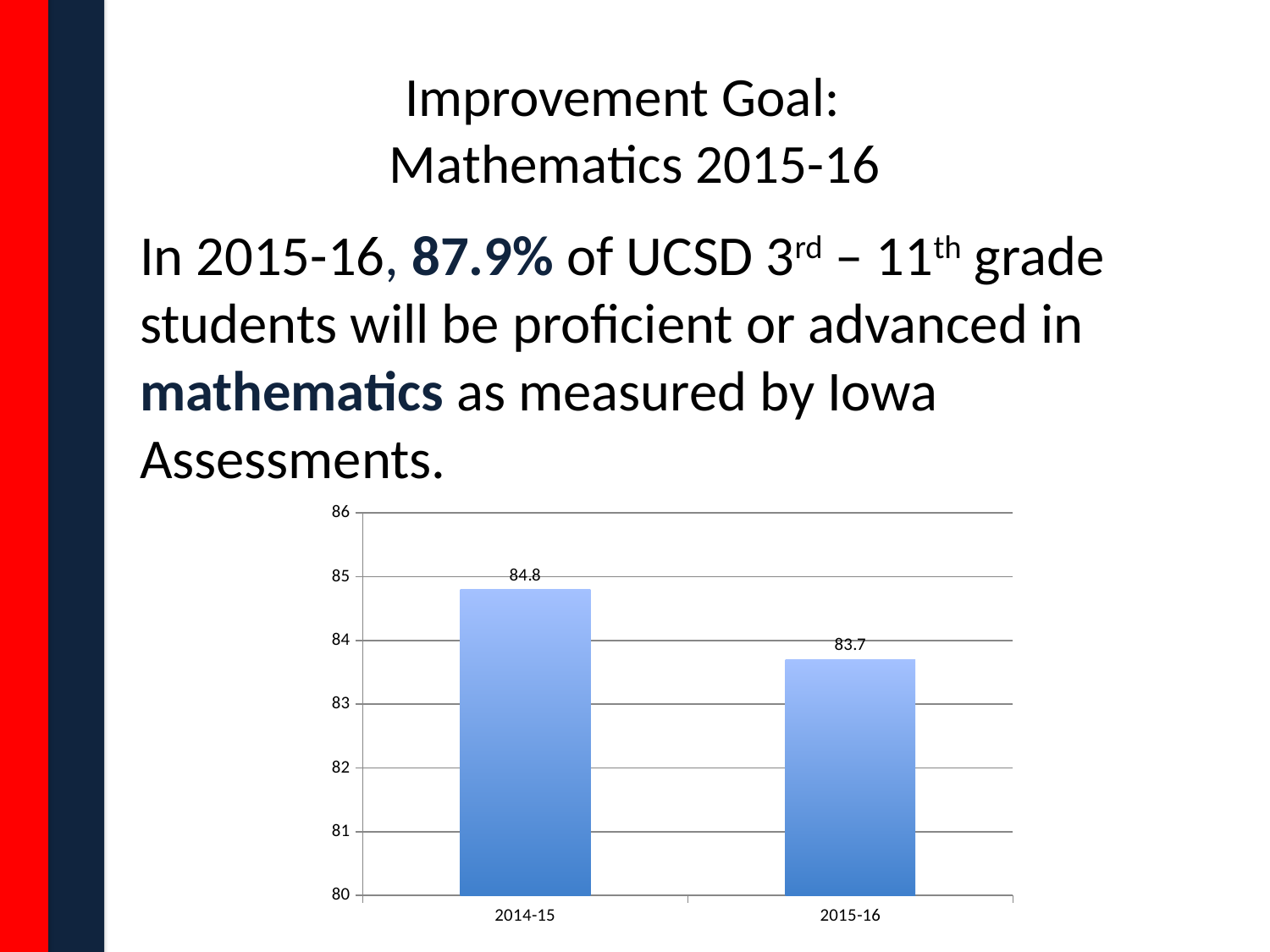
Is the value for 2014-15 greater or less than 84? greater What is the value for 2015-16? 83.7 Which category has the lowest value? 2015-16 Which is larger, the value for 2014-15 or the value for 2015-16? 2014-15 What is the difference between the values for 2014-15 and 2015-16? 1.1 How many categories are shown on the x axis? 2 What is the value for 2014-15? 84.8 Is the value for 2015-16 greater or less than 84? less What kind of chart is shown on the slide? bar chart Do the values rise or fall from 2014-15 to 2015-16? fall What is the lowest value shown on the y axis? 80 Which category has the highest value? 2014-15